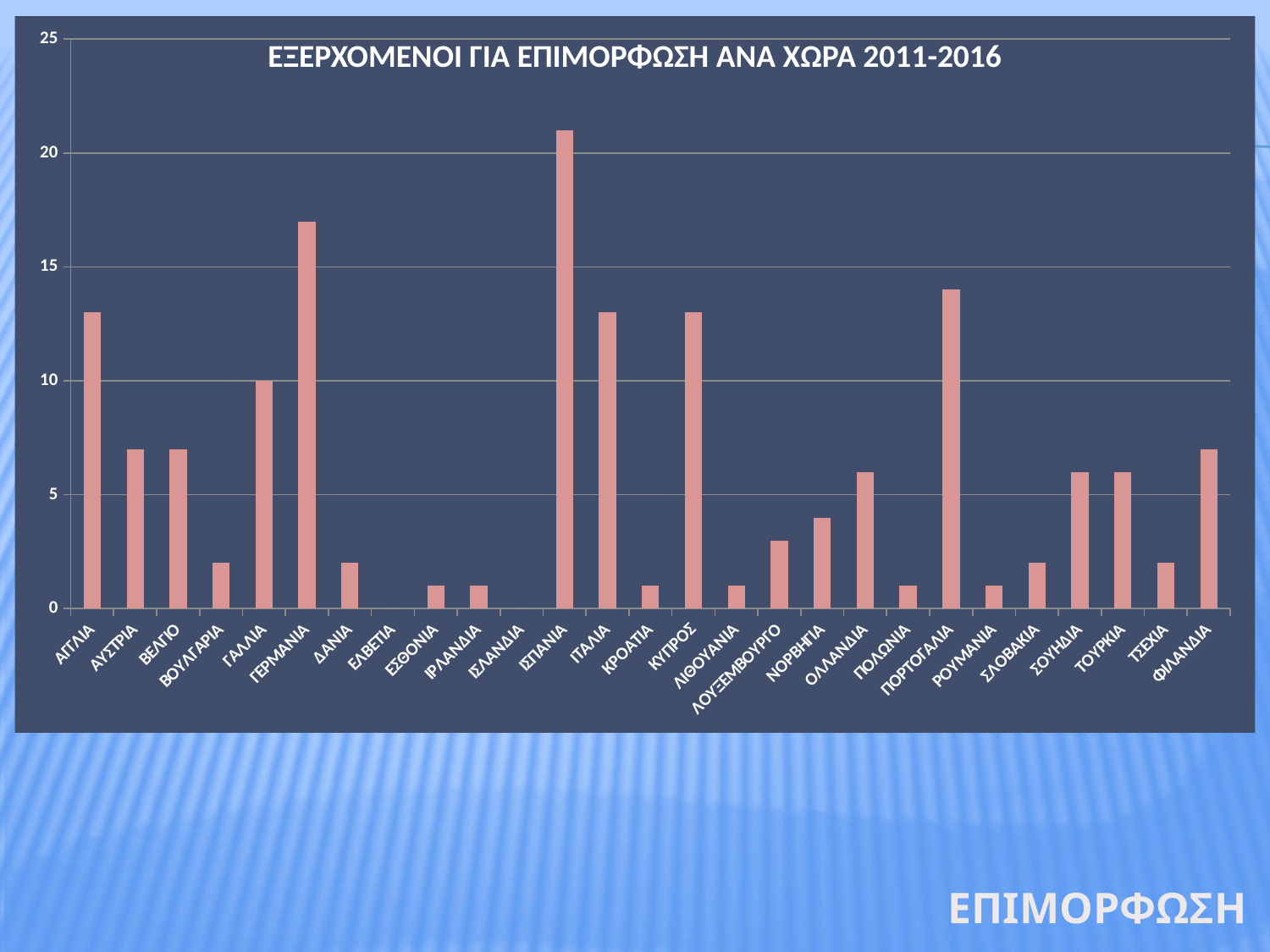
What is the title of the chart? ΕΞΕΡΧΟΜΕΝΟΙ ΓΙΑ ΕΠΙΜΟΡΦΩΣΗ ΑΝΑ ΧΩΡΑ 2011-2016 Which has the larger value, ΓΕΡΜΑΝΙΑ or ΠΟΡΤΟΓΑΛΙΑ? ΓΕΡΜΑΝΙΑ How many countries are shown on the x axis of the chart? 27 Is the value for ΠΟΡΤΟΓΑΛΙΑ greater or less than 15? less Is the value for ΒΟΥΛΓΑΡΙΑ greater or less than 5? less What type of chart is shown on the slide? Bar chart Is the value for ΙΣΠΑΝΙΑ greater or less than 20? greater Which country has the highest bar in the chart? ΙΣΠΑΝΙΑ Which has the larger value, ΚΥΠΡΟΣ or ΝΟΡΒΗΓΙΑ? ΚΥΠΡΟΣ What is the highest value shown on the y axis of the chart? 25